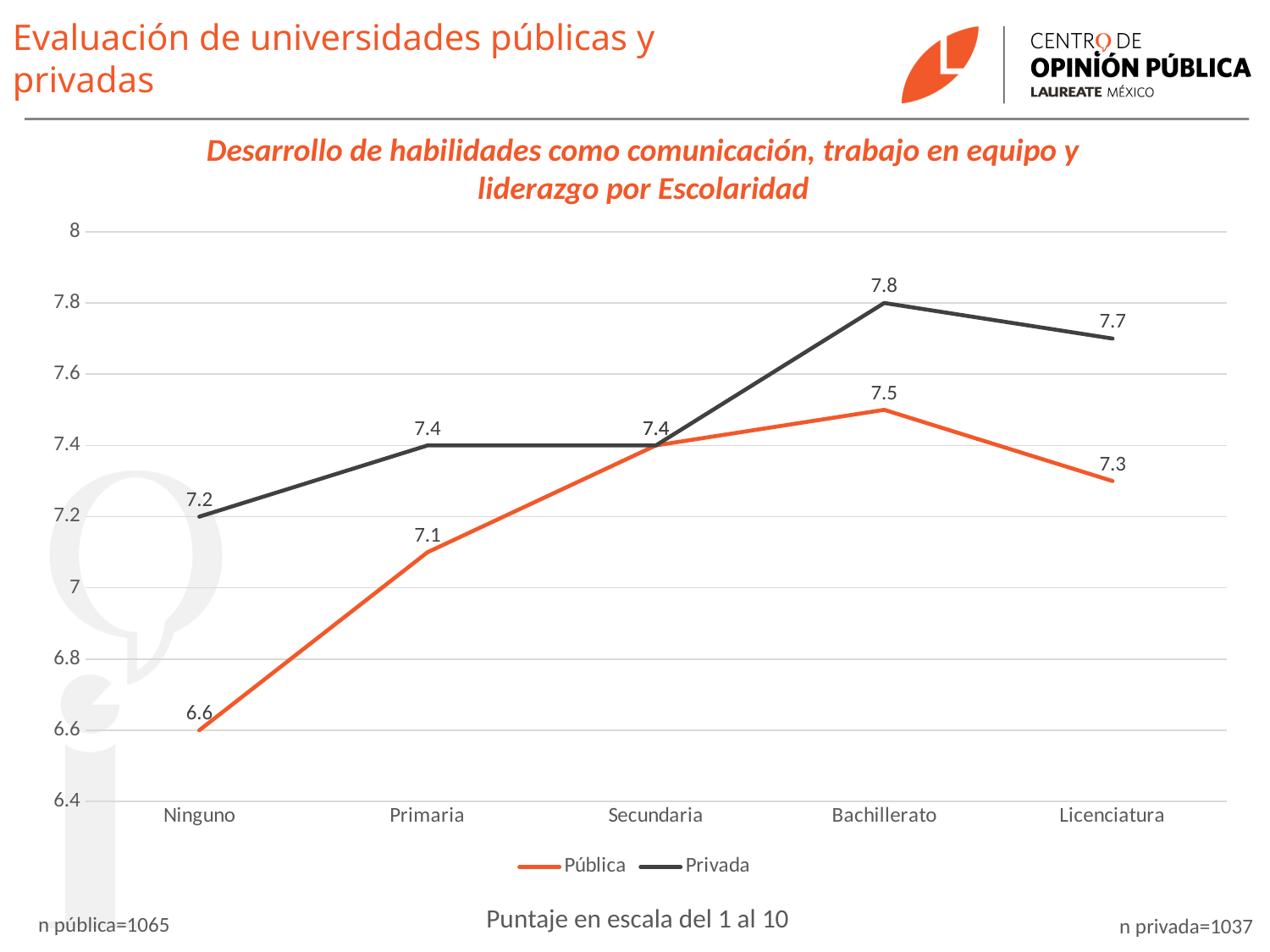
What is the value for Privada at Licenciatura? 7.7 What is the value for Pública at Ninguno? 6.6 At which education level does the Pública series reach its highest value? Bachillerato What is the difference between the Privada and Pública values at Ninguno? 0.6 At which education level does the Pública series have its lowest value? Ninguno How many education levels are shown on the x axis? 5 At Licenciatura, which series has the higher value, Pública or Privada? Privada What is the value for Pública at Primaria? 7.1 How many series does the legend list? 2 What kind of chart is shown on the slide? Line chart What is the value for Privada at Bachillerato? 7.8 Does the Pública series rise or fall from Ninguno to Bachillerato? Rise